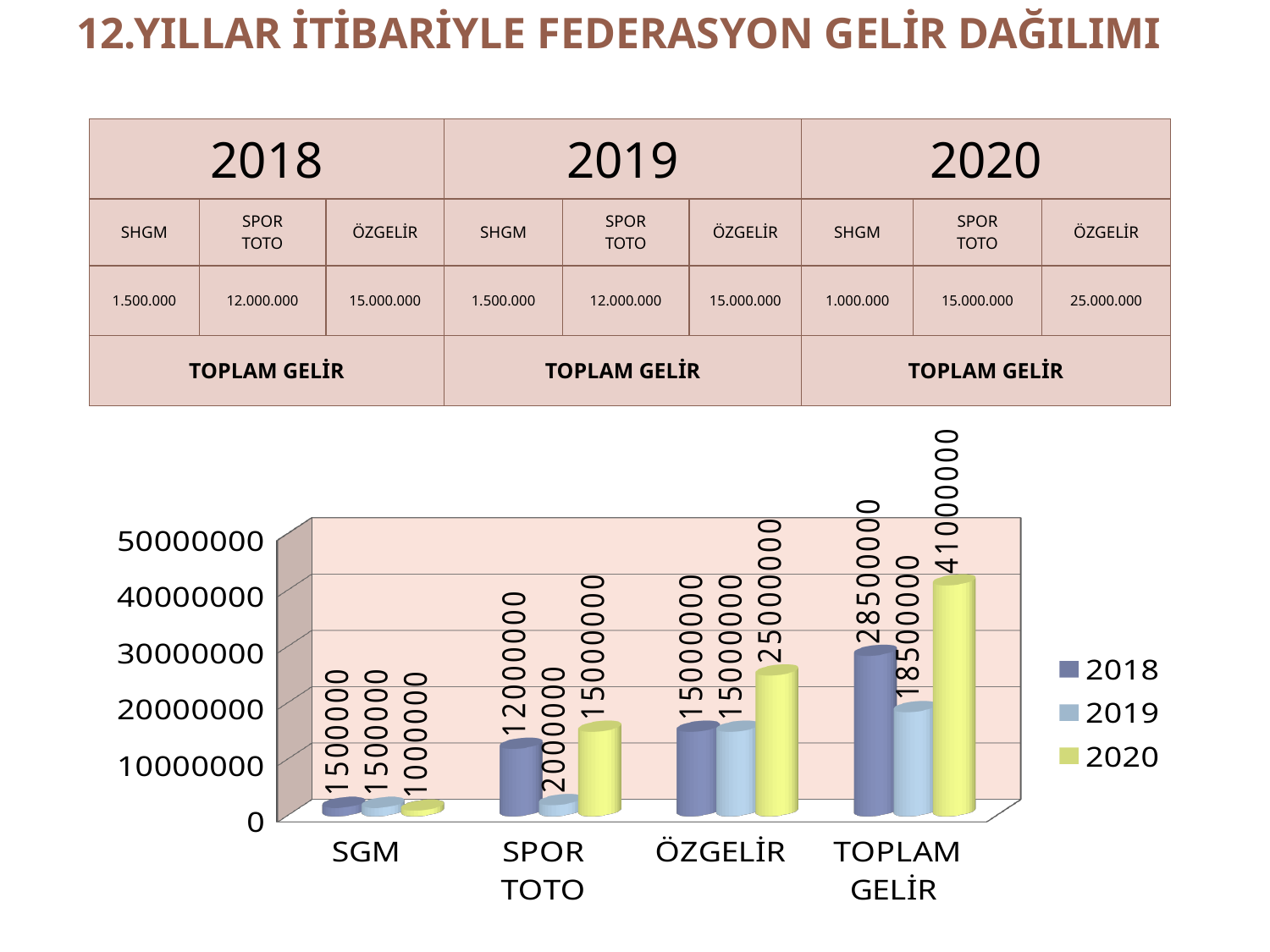
How many categories are shown on the x axis of the chart? 4 Which category has the highest value for the 2020 series? TOPLAM GELİR Which category has the lowest value for the 2018 series? SGM What is the value for SGM in 2020? 1000000 What is the difference between the TOPLAM GELİR values for 2020 and 2018? 12500000 What is the value for ÖZGELİR in 2020? 25000000 What is the value for SPOR TOTO in 2018? 12000000 What is the value for TOPLAM GELİR in 2020? 41000000 Which series is shown in yellow-green in the chart legend? 2020 What type of chart is shown on the slide? bar chart Which is larger, the 2019 value for SPOR TOTO or the 2019 value for ÖZGELİR? ÖZGELİR How many series does the chart legend list? 3